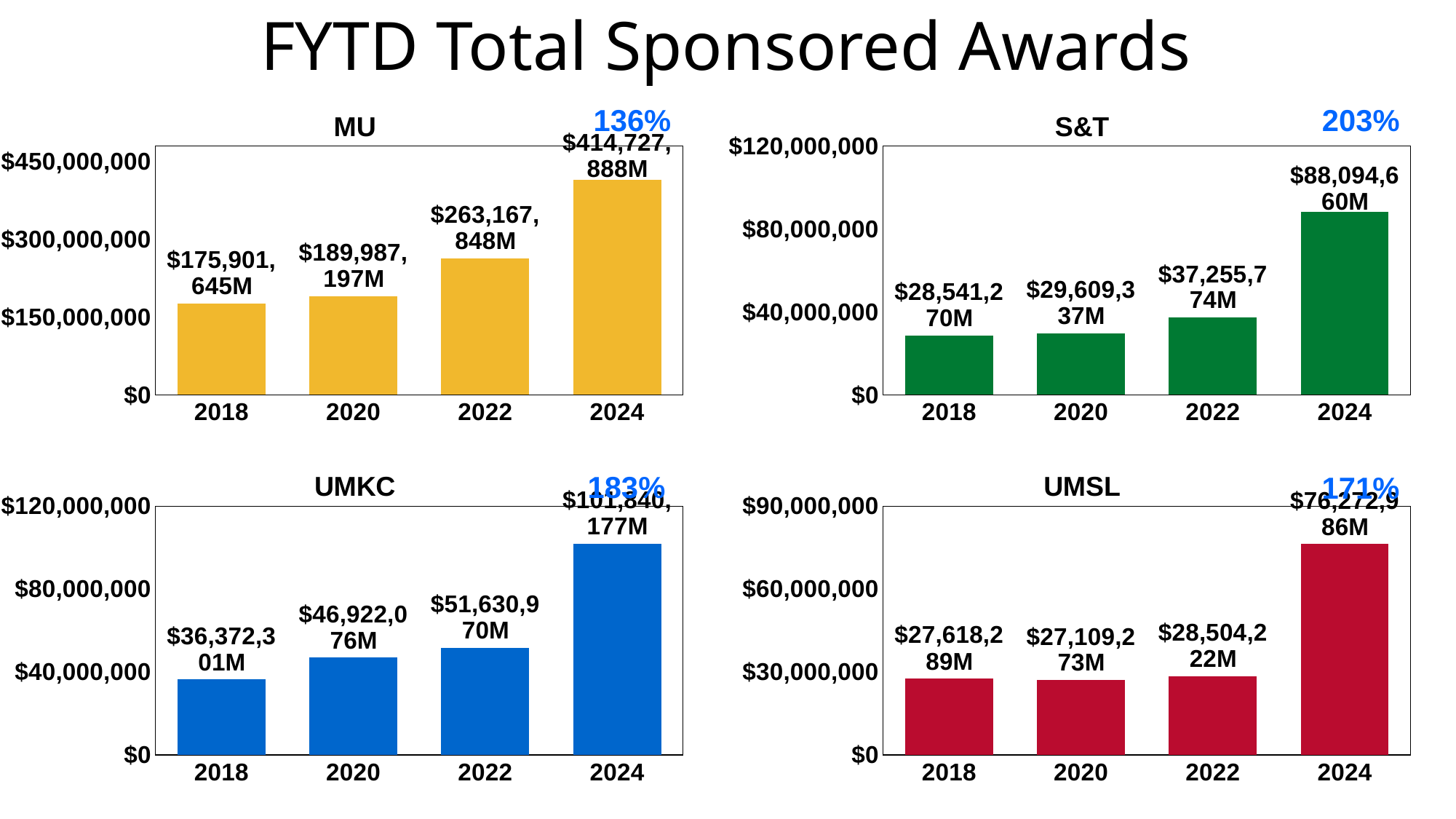
In the MU chart, what is the value for 2018? $175,901,645M In the MU chart, what is the difference between the 2024 and 2022 values? $151,560,040M In the S&T chart, do the values rise or fall from 2018 to 2024? rise In the S&T chart, which year has the lowest value? 2018 In the UMSL chart, what is the value for 2020? $27,109,273M In the UMKC chart, what is the value for 2022? $51,630,970M What kind of chart is the S&T chart? bar chart How many bars does the UMSL chart have? 4 In the MU chart, is the value for 2022 greater or less than $300,000,000? less Which is larger: the 2020 value in the UMKC chart or the 2020 value in the S&T chart? UMKC In the S&T chart, what is the value for 2024? $88,094,660M In the MU chart, which year has the highest value? 2024